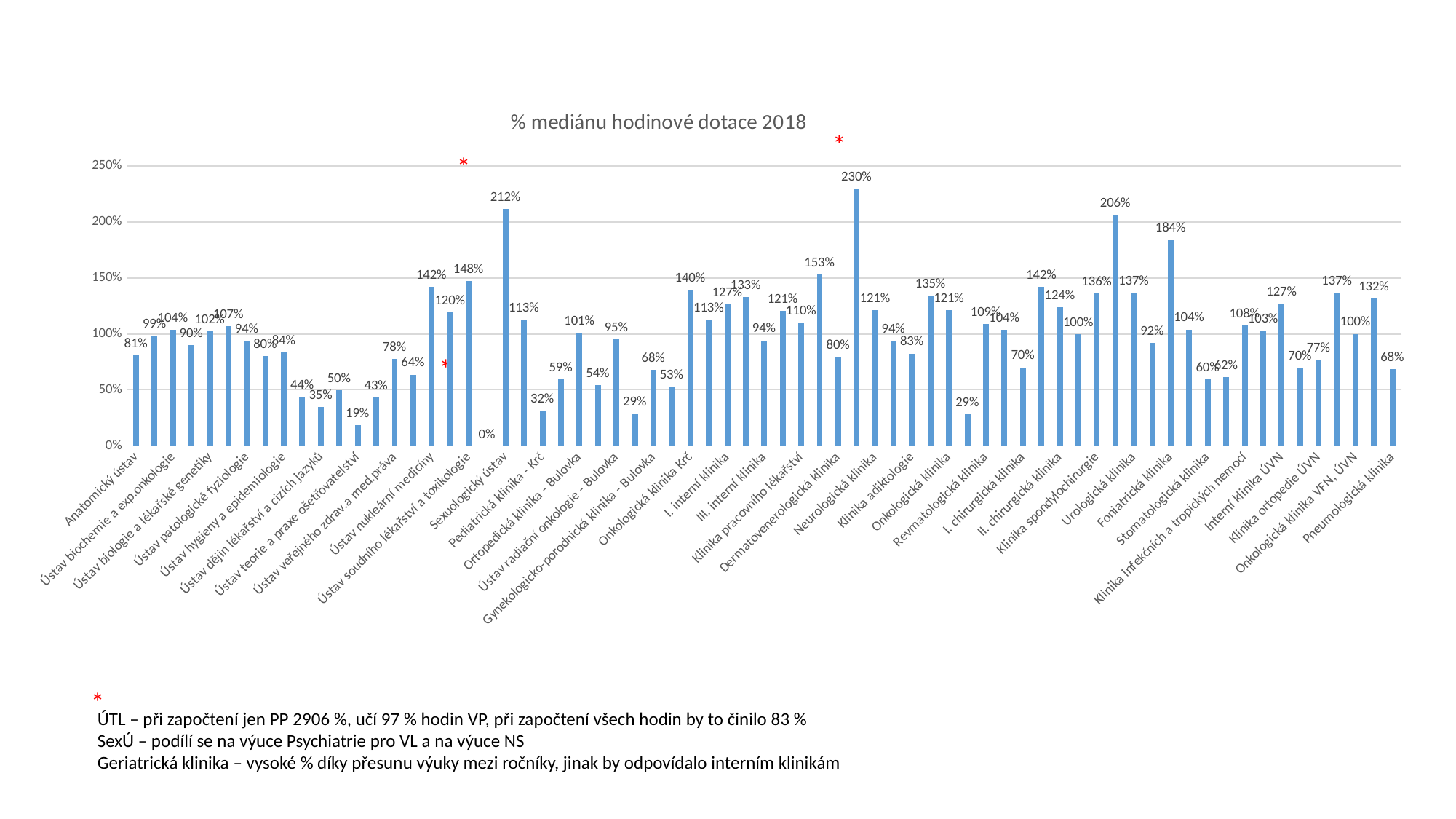
What is the value for Foniatrická klinika? 184% Which is larger, the value for Sexuologický ústav or the value for Foniatrická klinika? Sexuologický ústav What is the value for Urologická klinika? 137% What is the value for Sexuologický ústav? 212% What is the value for Ústav soudního lékařství a toxikologie? 148% What is the value for Anatomický ústav? 81% What is the value for Pneumologická klinika? 68% By how many percentage points does the value for Sexuologický ústav exceed the value for Foniatrická klinika? 28 percentage points What is the highest value shown in the chart? 230% What is the title of the chart? % mediánu hodinové dotace 2018 What is the lowest value shown in the chart? 0% What kind of chart is shown on the slide? bar chart